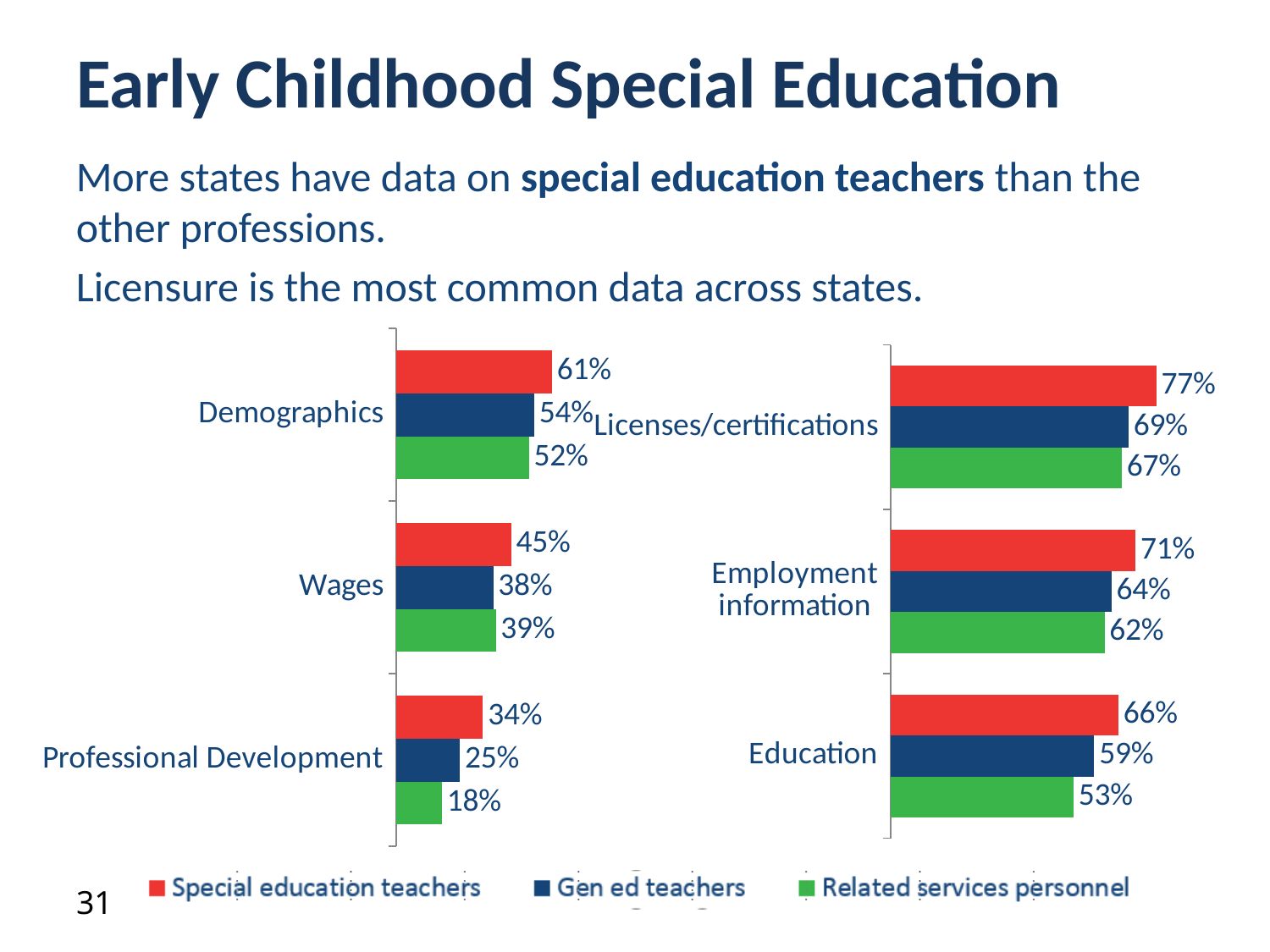
In the right chart, what is the value for Special education teachers in the Employment information category? 71% In the right chart, what is the difference between the Special education teachers value and the Gen ed teachers value in the Education category? 7% In the left chart, which is larger in the Wages category: the Gen ed teachers value or the Related services personnel value? Related services personnel In the left chart, which category has the lowest value for Related services personnel? Professional Development How many categories are shown in the right chart? 3 What kind of chart is the left chart? Bar chart In the right chart, which category has the highest value for Special education teachers? Licenses/certifications In the left chart, what is the difference between the Special education teachers value and the Related services personnel value in the Professional Development category? 16% In the left chart, what is the value for Special education teachers in the Demographics category? 61% How many series does the legend list? 3 In the left chart, what is the value for Gen ed teachers in the Wages category? 38% In the right chart, what is the value for Related services personnel in the Licenses/certifications category? 67%